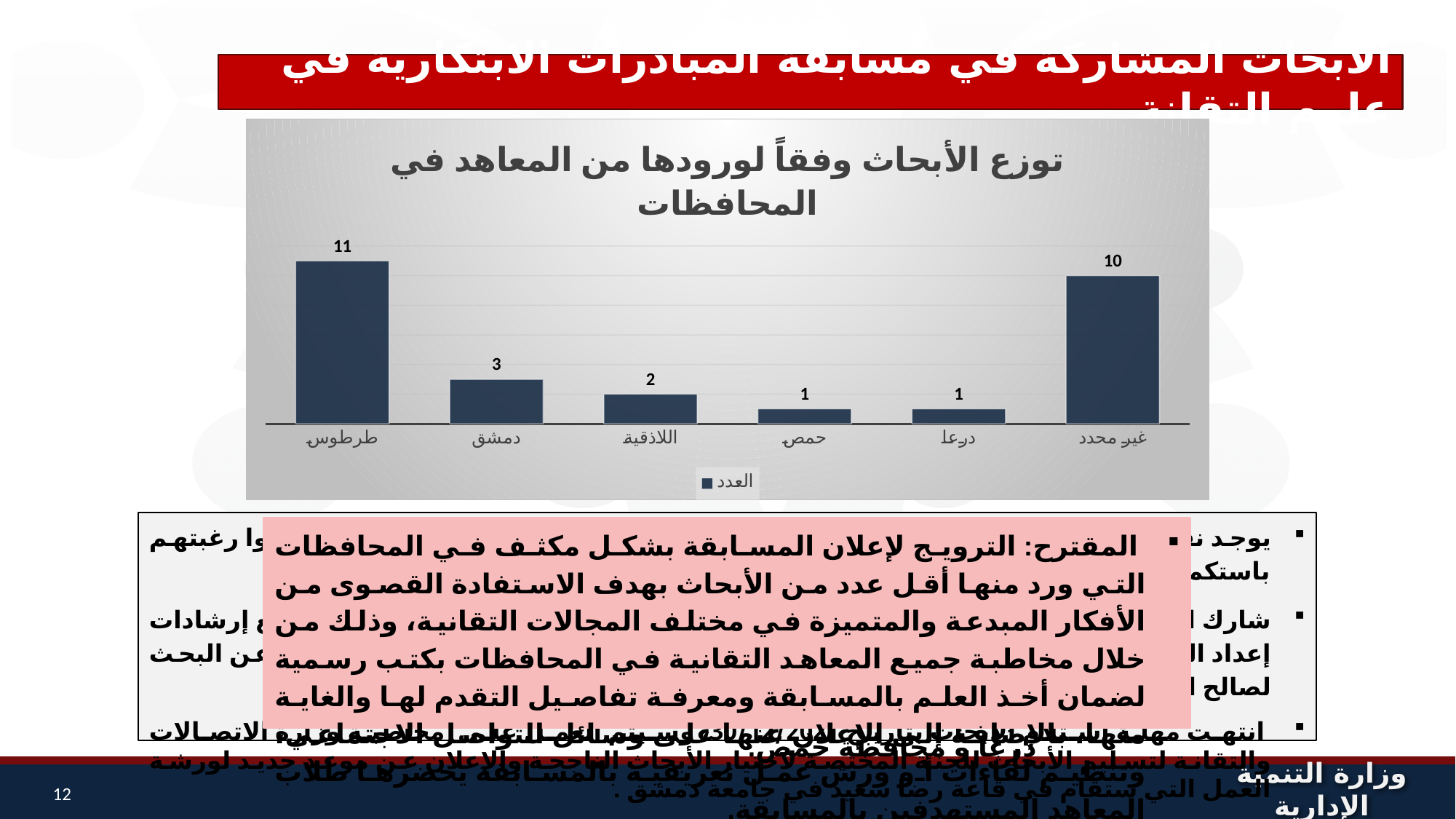
What is the difference between the values for دمشق and اللاذقية? 1 How many series does the legend list? 1 What is the value for غير محدد? 10 What is the value for دمشق? 3 What is the legend entry of the chart? العدد Which category has the highest value? طرطوس What is the value for اللاذقية? 2 What is the difference between the values for طرطوس and غير محدد? 1 What is the value for طرطوس? 11 Which is larger, the value for دمشق or the value for حمص? دمشق How many categories are shown on the x axis? 6 What type of chart is shown on the slide? bar chart